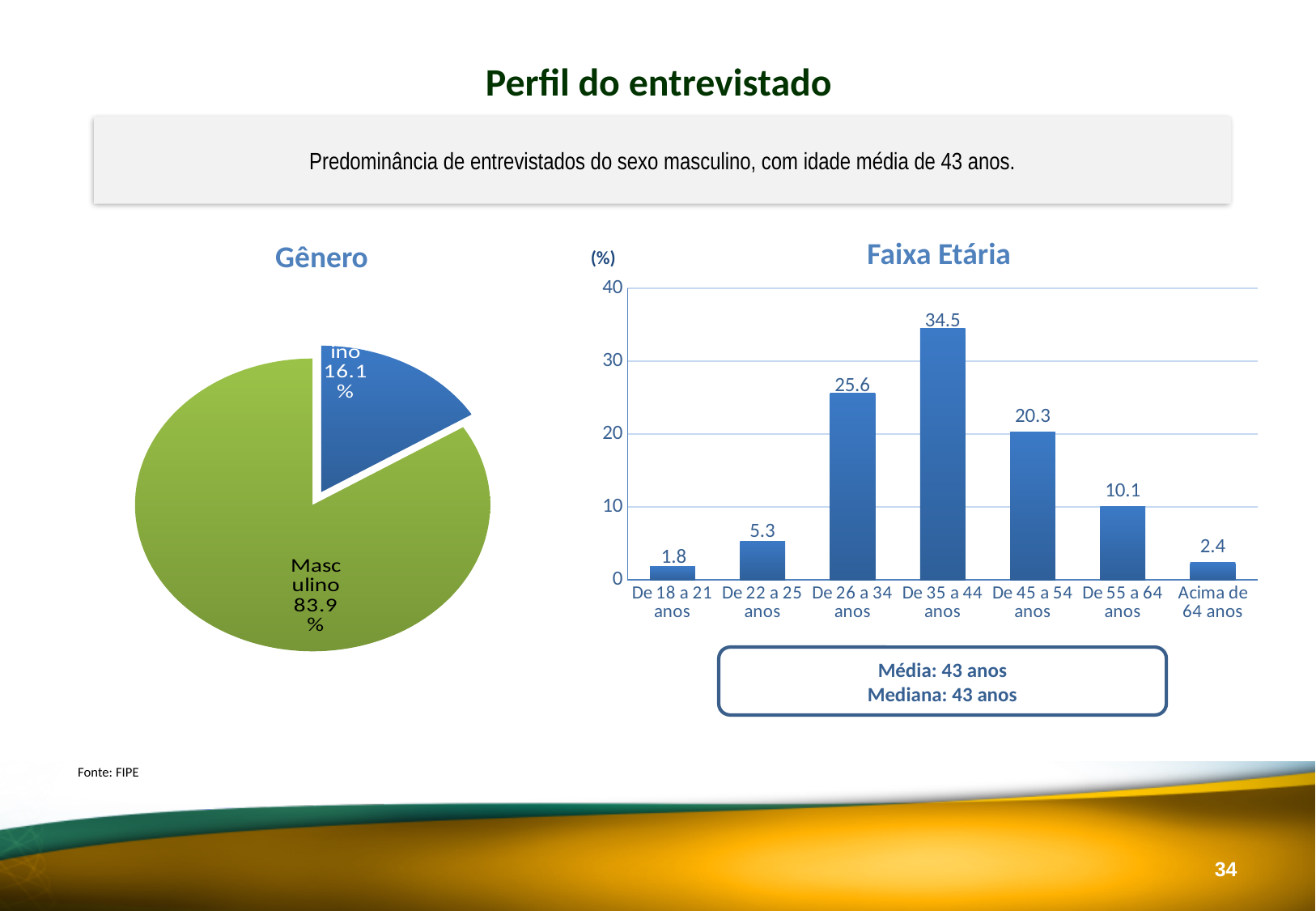
In the Faixa Etária chart, which age group has the lowest value? De 18 a 21 anos In the Gênero chart, what share does the blue slice represent? 16.1% In the Faixa Etária chart, what is the value for Acima de 64 anos? 2.4 In the Faixa Etária chart, which age group has the highest value? De 35 a 44 anos In the Faixa Etária chart, what is the difference between the values for De 35 a 44 anos and De 26 a 34 anos? 8.9 In the Faixa Etária chart, what is the value for De 35 a 44 anos? 34.5 What kind of chart is the Faixa Etária chart? Bar chart In the Faixa Etária chart, how many age groups are shown? 7 In the Faixa Etária chart, what is the value for De 22 a 25 anos? 5.3 In the Faixa Etária chart, which is larger: the value for De 45 a 54 anos or De 55 a 64 anos? De 45 a 54 anos In the Gênero chart, what share of respondents is Masculino? 83.9% What kind of chart is the Gênero chart? Pie chart